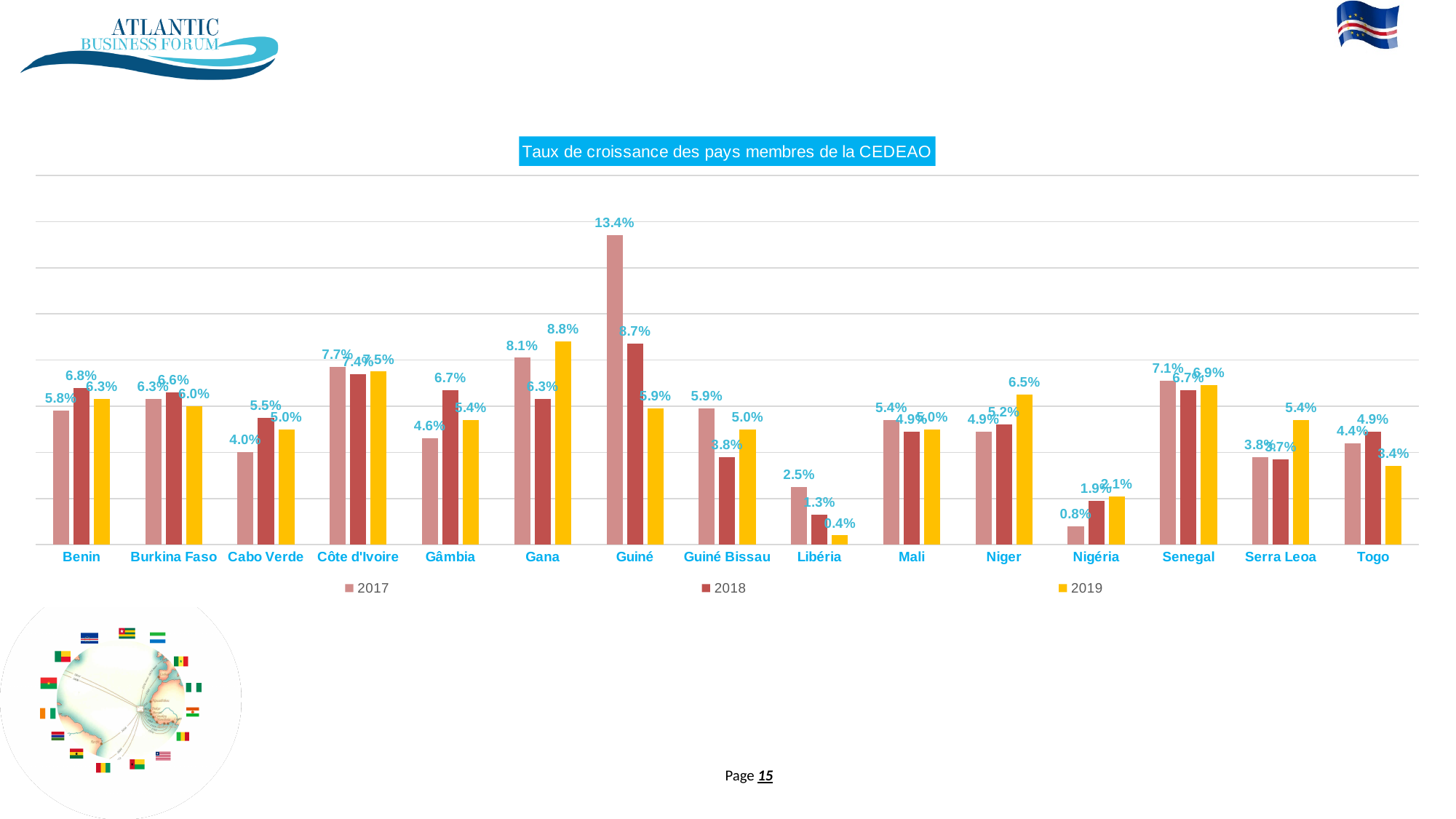
What is the 2017 value for Guiné? 13.4% What kind of chart is shown? bar chart Which is larger for Niger: the 2017 value or the 2019 value? 2019 What is the title of the chart? Taux de croissance des pays membres de la CEDEAO Which country has the highest 2017 value? Guiné Do the values for Libéria rise or fall from 2017 to 2019? fall What is the 2019 value for Gana? 8.8% Which country has the lowest 2019 value? Libéria What is the difference between the 2017 and 2019 values for Guiné? 7.5% How many countries are shown on the x axis? 15 How many series does the legend list? 3 What is the 2018 value for Cabo Verde? 5.5%